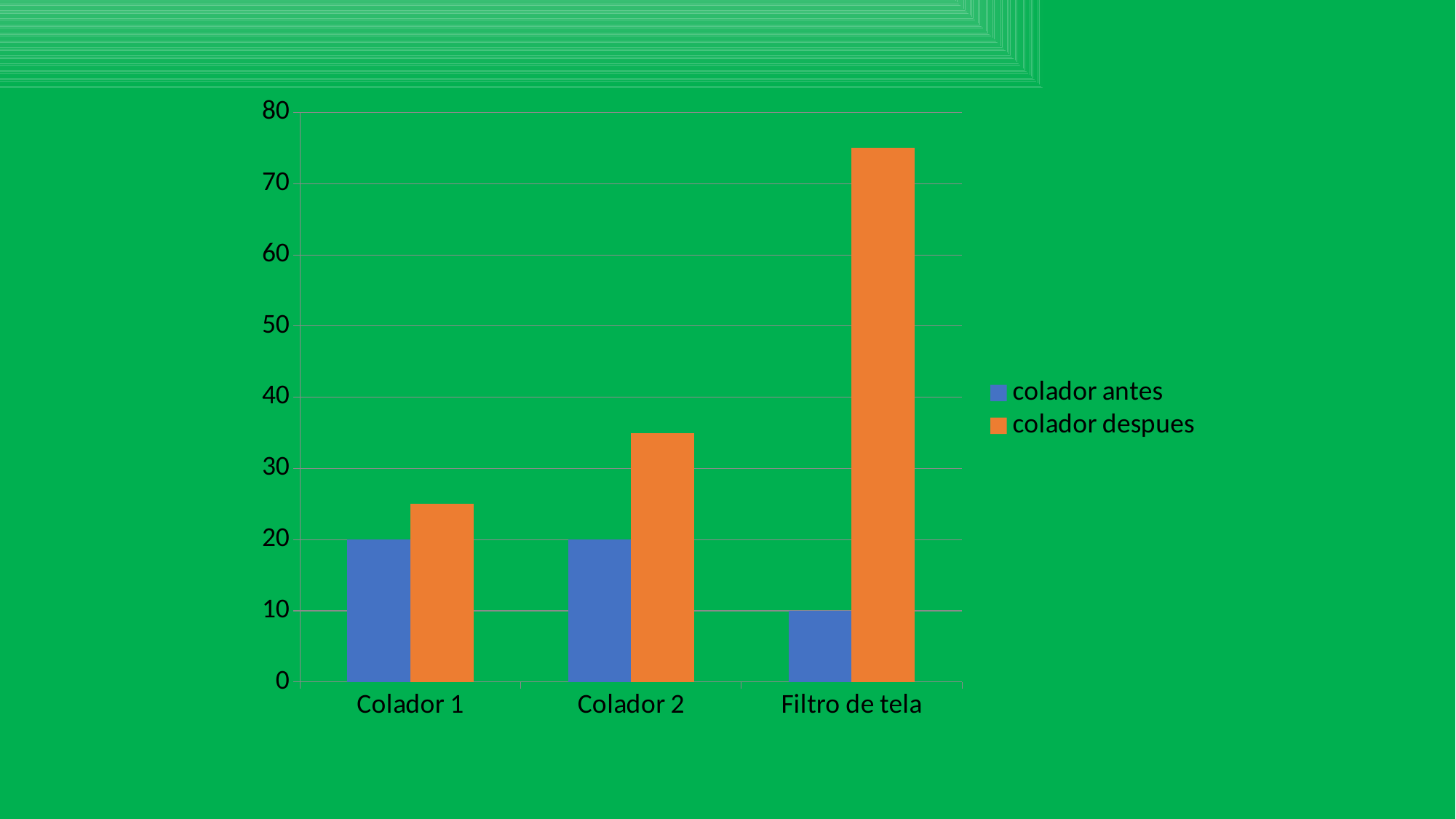
Which category has the highest colador despues value? Filtro de tela Is the colador despues value for Colador 2 greater or less than 30? greater What is the value of colador antes for Colador 1? 20 Is the colador despues value for Colador 1 greater or less than 30? less For Filtro de tela, which is larger: colador antes or colador despues? colador despues What is the difference between the colador antes values for Colador 1 and Filtro de tela? 10 Is the colador despues value for Filtro de tela greater or less than 70? greater What is the value of colador antes for Filtro de tela? 10 Which category has the lowest colador antes value? Filtro de tela How many categories are shown on the x axis? 3 What kind of chart is shown on the slide? bar chart How many series does the legend list? 2